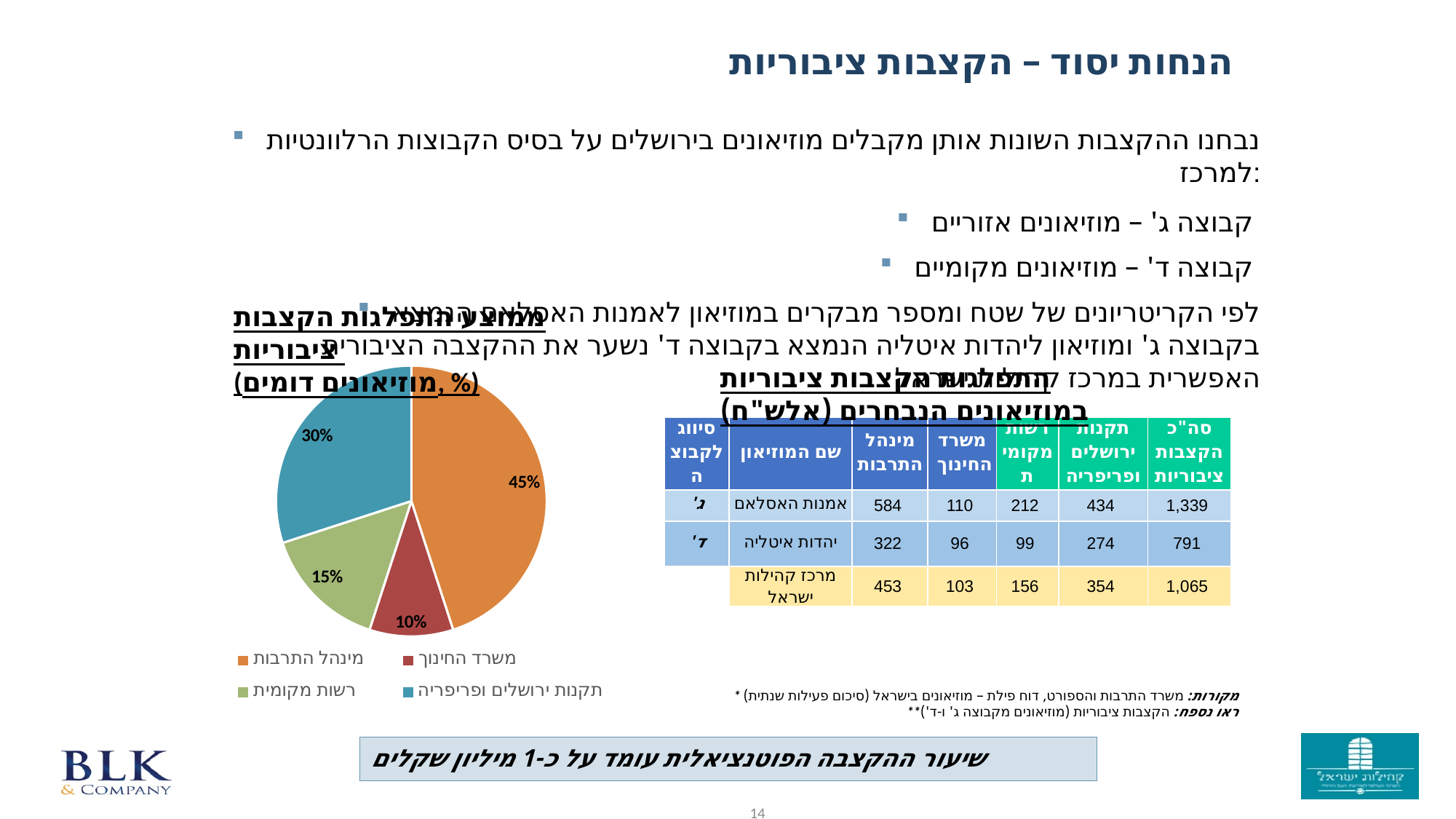
What kind of chart is shown on the slide? pie chart What colour is the slice for תקנות ירושלים ופריפריה? teal What is the difference in percentage points between מינהל התרבות and תקנות ירושלים ופריפריה? 15% Which category has the smallest slice of the pie? משרד החינוך What share of the pie does מינהל התרבות hold? 45% How many slices does the pie chart have? 4 What share of the pie does תקנות ירושלים ופריפריה hold? 30% What share of the pie does משרד החינוך hold? 10% What share of the pie does רשות מקומית hold? 15% How many entries does the legend of the pie chart list? 4 Which category has the largest slice of the pie? מינהל התרבות Which is larger: the slice for רשות מקומית or the slice for משרד החינוך? רשות מקומית